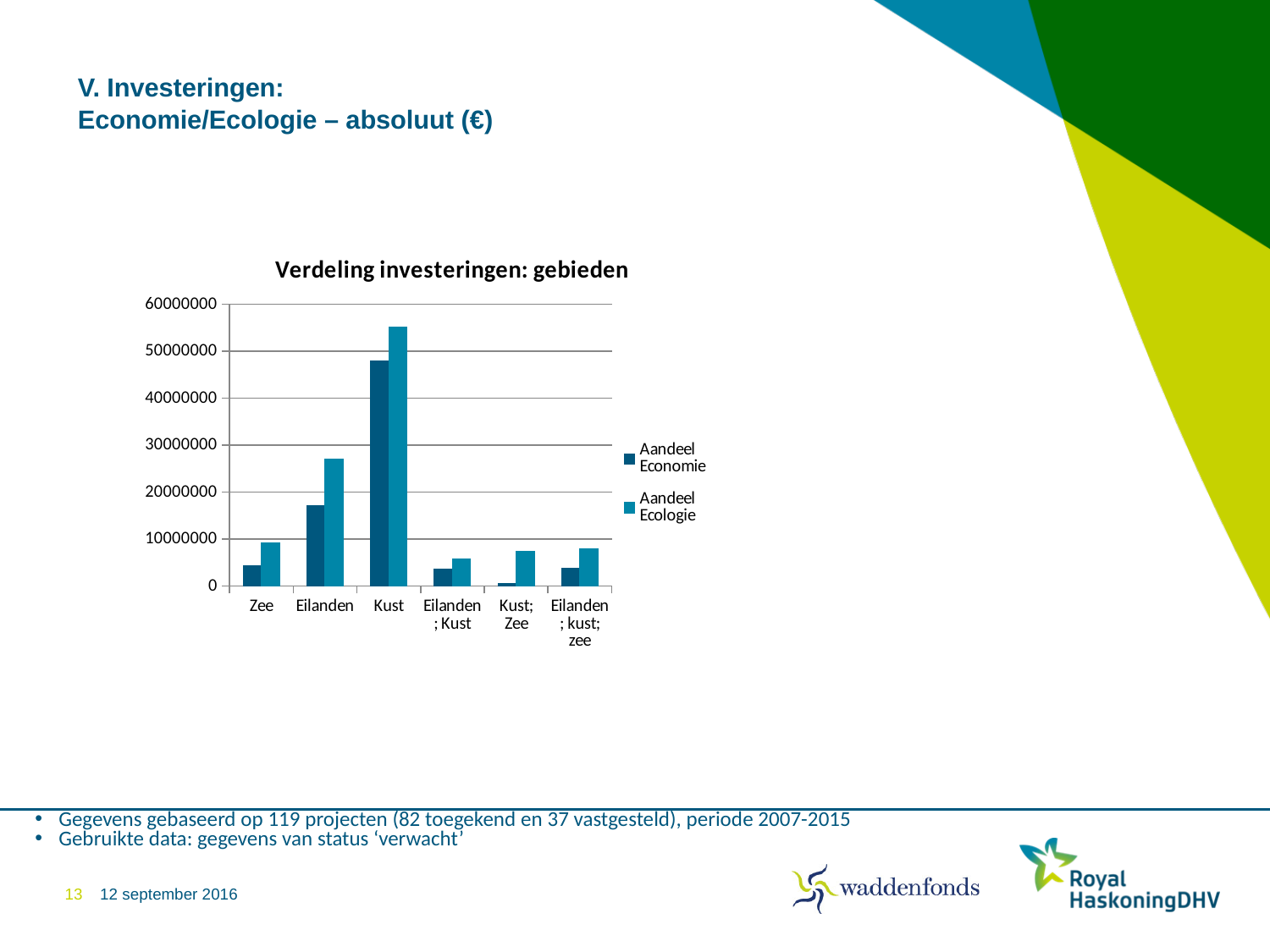
For Eilanden, which is larger: Aandeel Economie or Aandeel Ecologie? Aandeel Ecologie What kind of chart is shown on the slide? bar chart What are the two series named in the legend? Aandeel Economie and Aandeel Ecologie Is the value for Aandeel Ecologie in Kust greater or less than 50000000? greater How many series does the legend list? 2 What is the title of the chart? Verdeling investeringen: gebieden Is the value for Aandeel Ecologie in Zee greater or less than 20000000? less How many categories are shown on the x axis? 6 Which category has the highest value for Aandeel Ecologie? Kust Is the value for Aandeel Economie in Eilanden greater or less than 20000000? less Which category has the highest value for Aandeel Economie? Kust Which category has the lowest value for Aandeel Economie? Kust; Zee